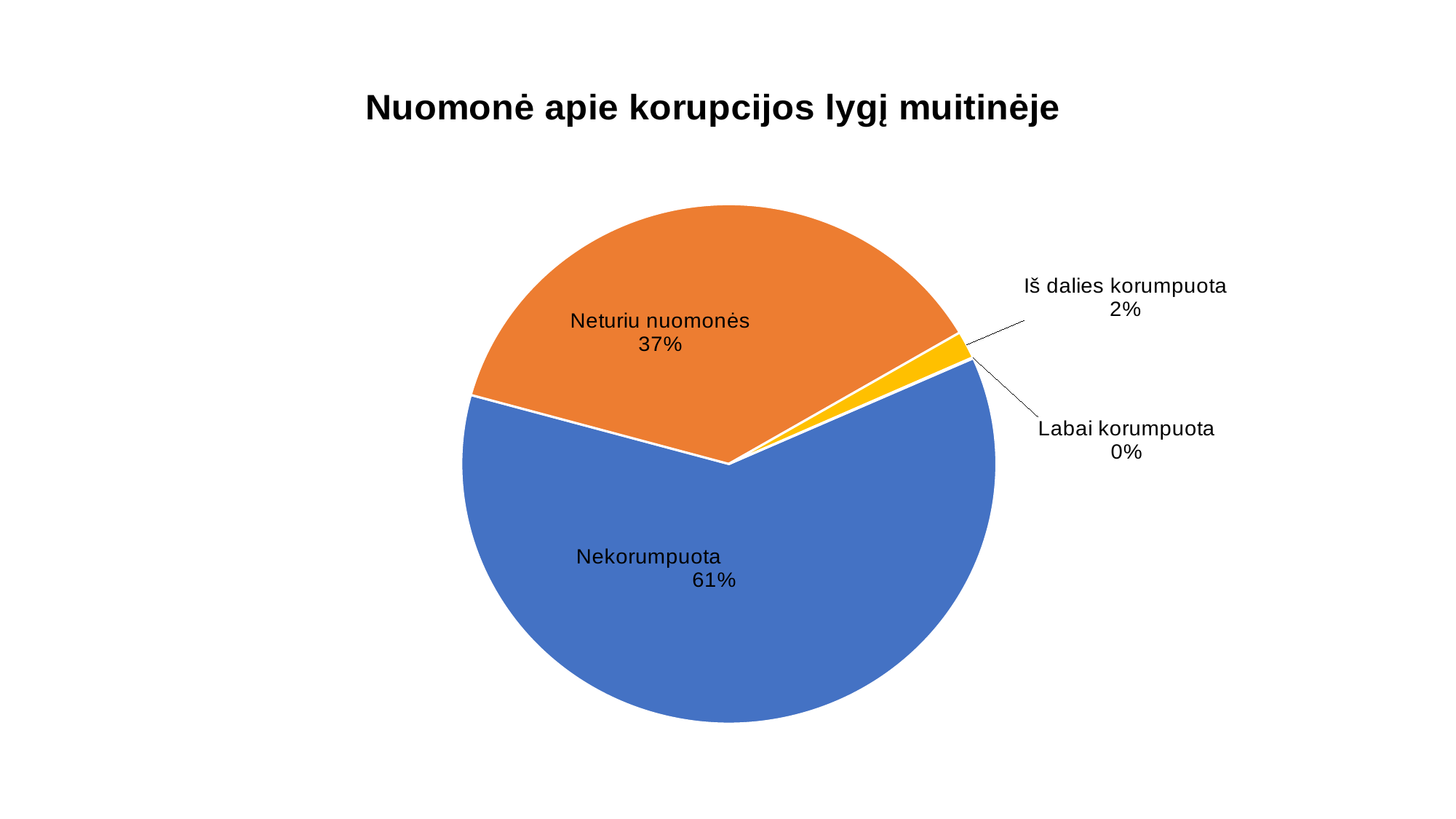
Which is larger, the share for Neturiu nuomonės or the share for Iš dalies korumpuota? Neturiu nuomonės Which category has the smallest value? Labai korumpuota What value is shown for Labai korumpuota? 0% What kind of chart is shown on the slide? pie chart How many categories are shown in the pie chart? 4 What is the title of the chart? Nuomonė apie korupcijos lygį muitinėje What share of the pie is labelled Neturiu nuomonės? 37% What is the difference between the Nekorumpuota and Neturiu nuomonės shares? 24% What colour is the Nekorumpuota slice? blue What share of the pie is labelled Iš dalies korumpuota? 2% What share of the pie is labelled Nekorumpuota? 61% Which category has the largest slice of the pie? Nekorumpuota